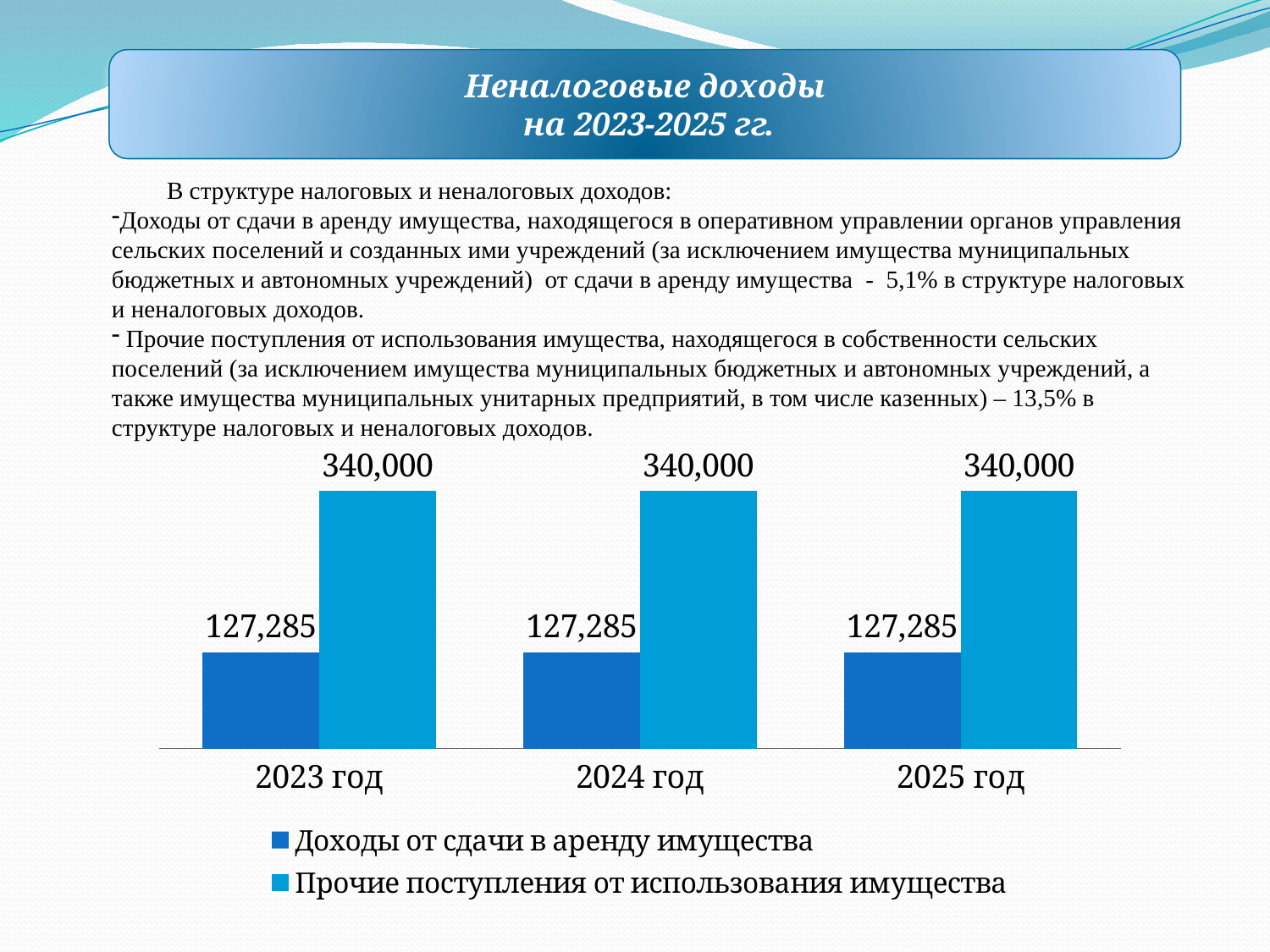
What is the value for "Прочие поступления от использования имущества" in 2024 год? 340,000 Which legend entry is shown in the lighter blue colour? Прочие поступления от использования имущества How many series does the legend list? 2 What is the value for "Прочие поступления от использования имущества" in 2025 год? 340,000 What is the value for "Доходы от сдачи в аренду имущества" in 2023 год? 127,285 What is the title of the slide containing the chart? Неналоговые доходы на 2023-2025 гг. What is the difference between "Прочие поступления от использования имущества" and "Доходы от сдачи в аренду имущества" in 2024 год? 212,715 Do the values for "Доходы от сдачи в аренду имущества" rise, fall or stay the same from 2023 год to 2025 год? Stay the same How many year categories are shown on the x axis? 3 Which series has the larger value in 2023 год? Прочие поступления от использования имущества What is the combined value of the two series in 2025 год? 467,285 What kind of chart is shown on the slide? Bar chart